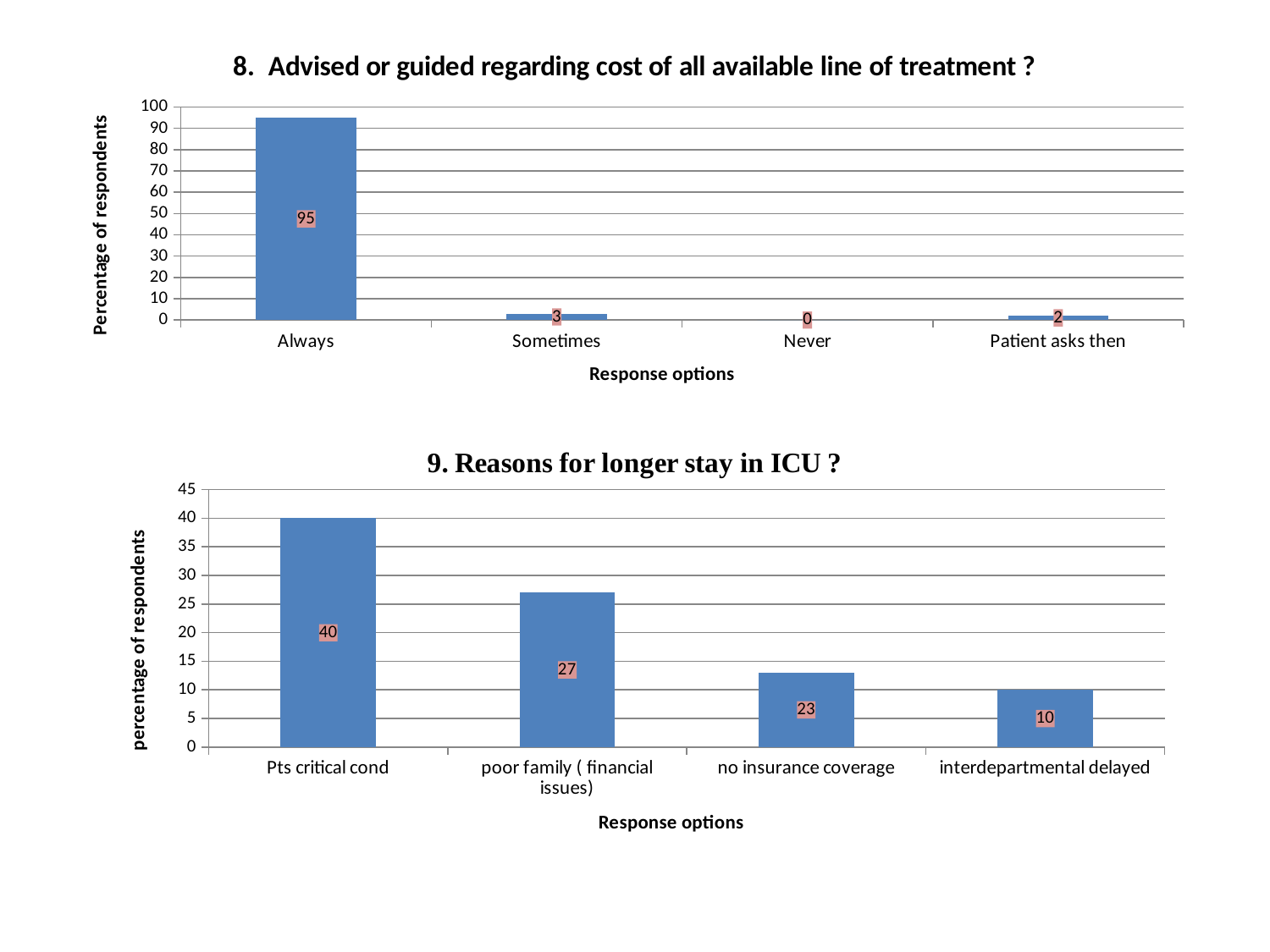
In the bottom chart, what is the difference between the values for Pts critical cond and poor family ( financial issues)? 13 What kind of chart is the top chart? Bar chart In the top chart, what is the difference between the values for Always and Sometimes? 92 In the chart titled "9. Reasons for longer stay in ICU ?", what is the value for interdepartmental delayed? 10 In the chart titled "8. Advised or guided regarding cost of all available line of treatment ?", what is the value for Always? 95 In the bottom chart, which reason has the highest value? Pts critical cond In the chart titled "9. Reasons for longer stay in ICU ?", what is the value for Pts critical cond? 40 In the top chart, which response option has the lowest value? Never In the chart titled "8. Advised or guided regarding cost of all available line of treatment ?", what is the value for Sometimes? 3 In the top chart, which response option has the highest value? Always In the bottom chart, which is larger: the value for poor family ( financial issues) or the value for interdepartmental delayed? poor family ( financial issues) How many response options are shown in the top chart? 4